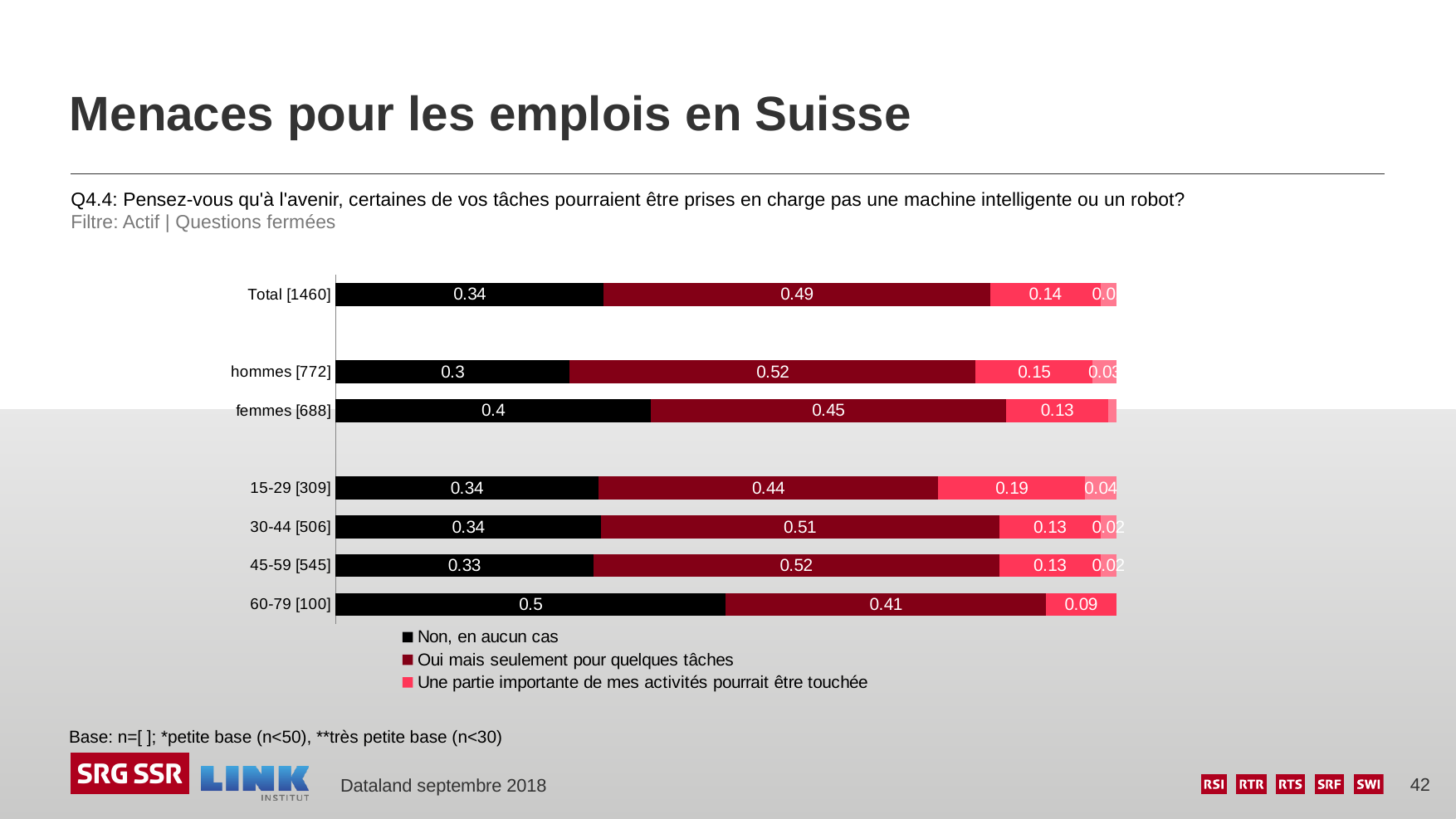
What is the value of "Oui mais seulement pour quelques tâches" for hommes [772]? 0.52 What is the value of "Non, en aucun cas" for 60-79 [100]? 0.5 How many series does the legend list? 3 Which category has the lowest value for "Non, en aucun cas"? hommes [772] What colour represents "Non, en aucun cas" in the chart? black What is the value of "Non, en aucun cas" for Total [1460]? 0.34 Which is larger: the "Oui mais seulement pour quelques tâches" value for 15-29 [309] or for 30-44 [506]? 30-44 [506] Which category has the highest value for "Non, en aucun cas"? 60-79 [100] What is the value of "Une partie importante de mes activités pourrait être touchée" for 15-29 [309]? 0.19 What kind of chart is shown on the slide? stacked bar chart How many categories (rows) are plotted in the chart? 7 What is the difference between the "Non, en aucun cas" values for femmes [688] and hommes [772]? 0.1